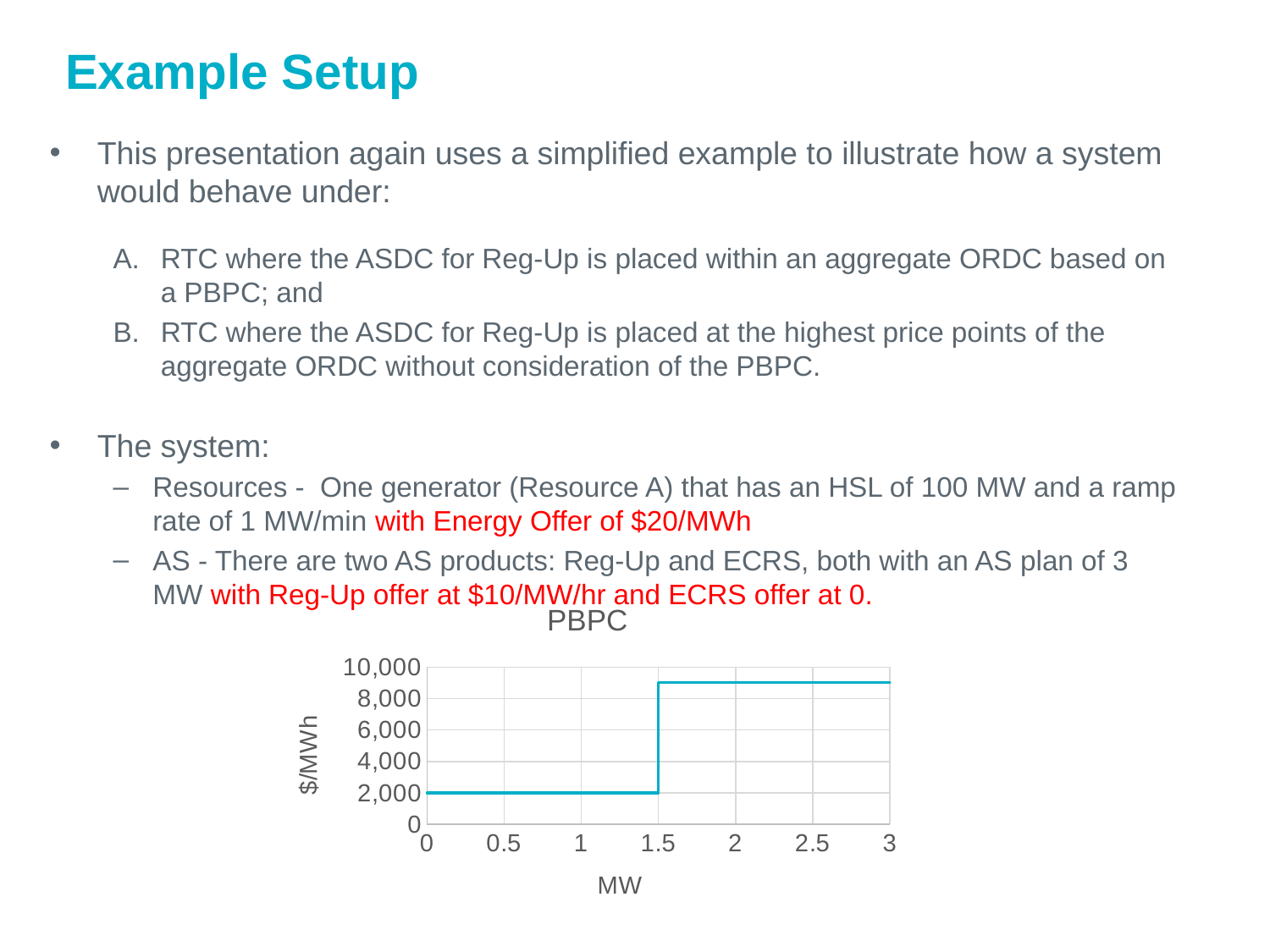
Is the value at 1 MW on the PBPC chart greater or less than 4,000? less What is the title of the chart? PBPC What is the highest tick value shown on the y axis of the PBPC chart? 10,000 What is the value in $/MWh at 0.5 MW on the PBPC chart? 2,000 What is the label of the x axis of the chart? MW What kind of chart is shown on the slide? line chart At what MW value does the PBPC curve step up to its higher level? 1.5 Is the value at 2.5 MW on the PBPC chart greater or less than 10,000? less What is the value in $/MWh at 1 MW on the PBPC chart? 2,000 Which has the larger value on the PBPC chart, 1 MW or 2.5 MW? 2.5 MW Is the value at 2 MW on the PBPC chart greater or less than 8,000? greater Do the values on the PBPC chart rise or fall as MW increases from 0 to 3? rise